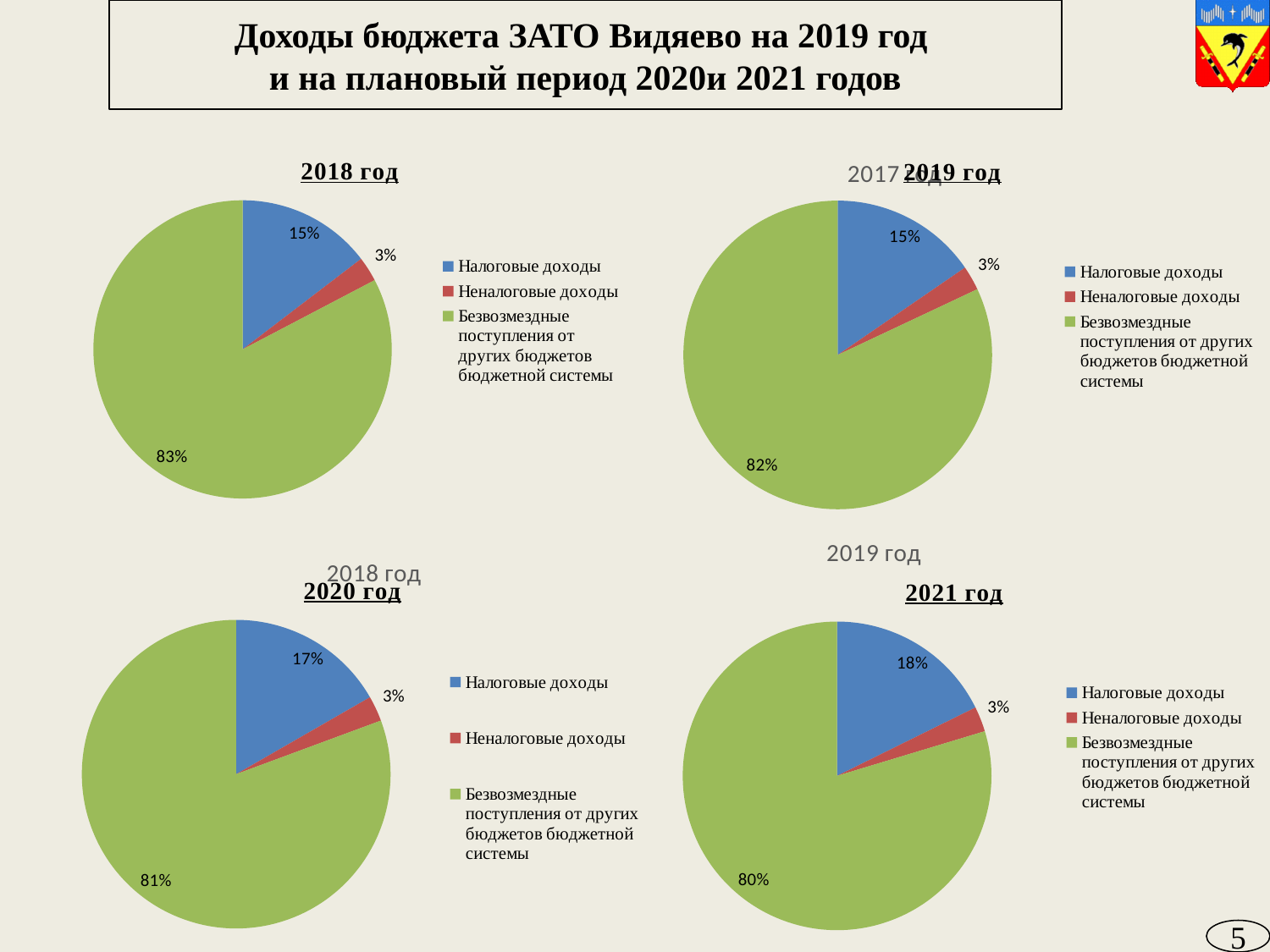
In the "2020 год" pie chart, what share is shown for Налоговые доходы? 17% In the "2020 год" pie chart, which category has the largest slice? Безвозмездные поступления от других бюджетов бюджетной системы In the "2018 год" pie chart, what share is shown for Безвозмездные поступления от других бюджетов бюджетной системы? 83% What type of chart is used for "2021 год"? Pie chart In the "2018 год" pie chart, what share is shown for Налоговые доходы? 15% In the "2019 год" pie chart, what share is shown for Безвозмездные поступления от других бюджетов бюджетной системы? 82% Which is larger: the share of Налоговые доходы in the "2018 год" chart or in the "2021 год" chart? 2021 год In the "2021 год" pie chart, what is the difference between the shares of Налоговые доходы and Неналоговые доходы? 15% In the "2021 год" pie chart, what share is shown for Неналоговые доходы? 3% In the "2021 год" pie chart, what share is shown for Налоговые доходы? 18% In the "2019 год" pie chart, which category has the smallest slice? Неналоговые доходы How many slices does the "2020 год" pie chart have? 3